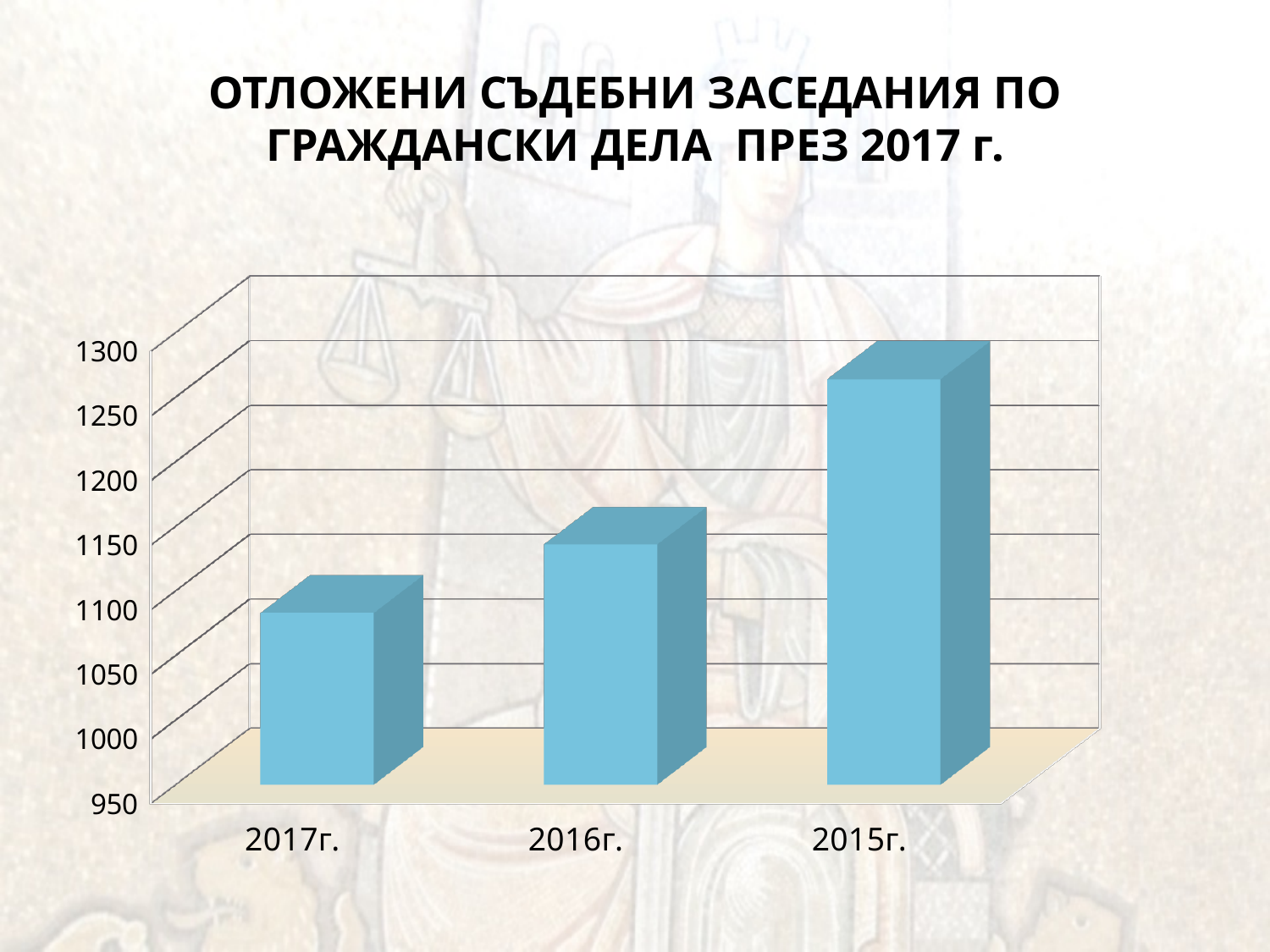
Is the value for 2016г. greater or less than 1100? greater Which is larger, the value for 2015г. or the value for 2016г.? 2015г. Is the value for 2015г. greater or less than 1200? greater What kind of chart is shown on the slide? bar chart Is the value for 2017г. greater or less than 1050? greater How many categories are shown on the x axis of the chart? 3 Which is larger, the value for 2016г. or the value for 2017г.? 2016г. Which category has the highest bar in the chart? 2015г. Which category has the lowest bar in the chart? 2017г. What is the title of the slide containing the chart? ОТЛОЖЕНИ СЪДЕБНИ ЗАСЕДАНИЯ ПО ГРАЖДАНСКИ ДЕЛА ПРЕЗ 2017 г. Do the bar values rise or fall moving from left to right along the x axis (from 2017г. to 2015г.)? rise